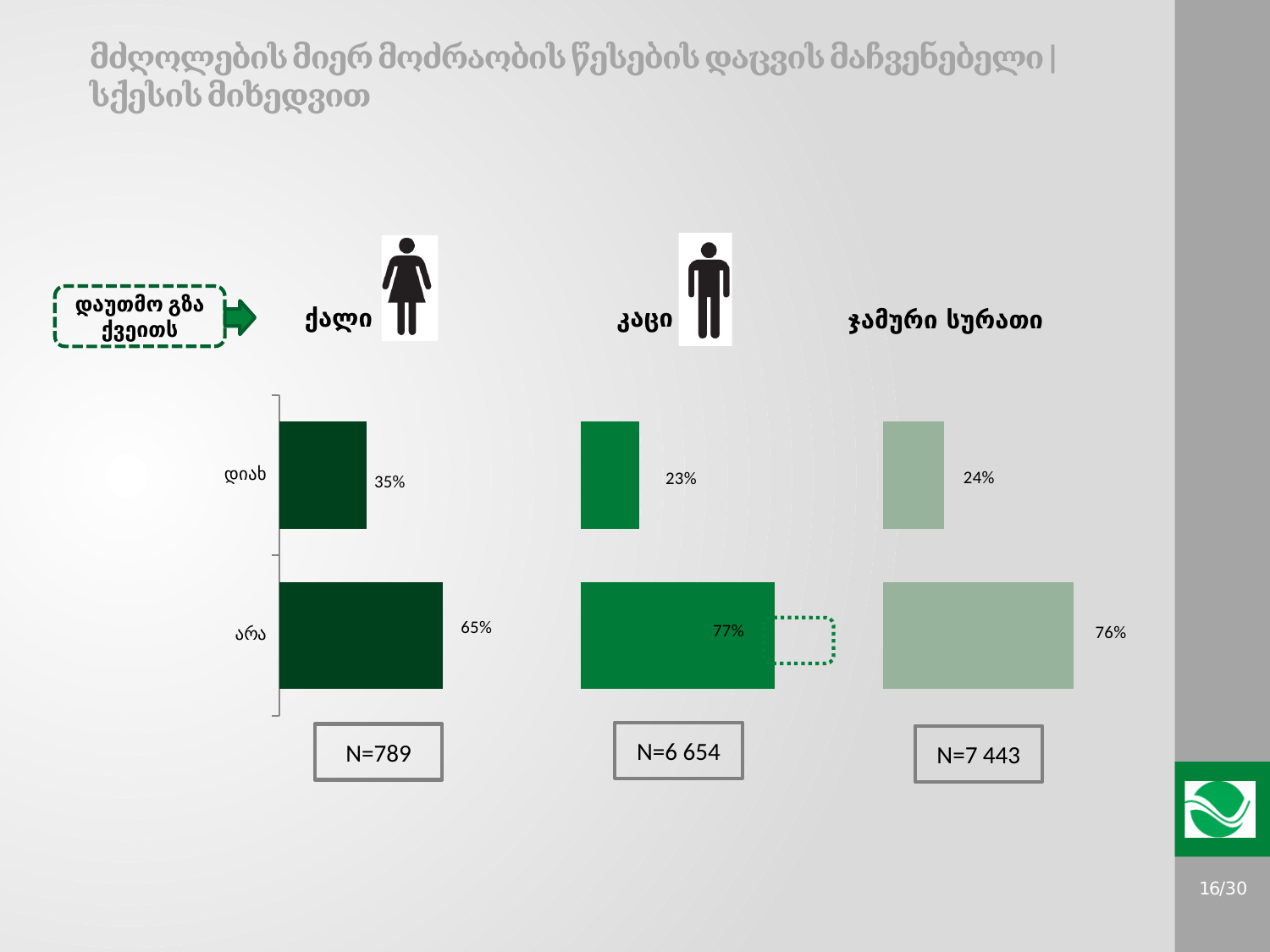
In the left chart (ქალი), which category has the lowest value? დიახ In the left chart (ქალი), what is the difference between the values for არა and დიახ? 30% In the right chart (ჯამური სურათი), what is the value for არა? 76% In the middle chart (კაცი), what is the value for არა? 77% In the middle chart (კაცი), what is the value for დიახ? 23% How many categories does each chart on the slide show? 2 What type of chart is used on the slide? Bar chart In the right chart (ჯამური სურათი), what is the value for დიახ? 24% Which is larger: the დიახ value in the left chart (ქალი) or the დიახ value in the middle chart (კაცი)? ქალი (35%) In the left chart (ქალი), what is the value for არა? 65% In the left chart (ქალი), what is the value for დიახ? 35% In the middle chart (კაცი), which category has the highest value? არა